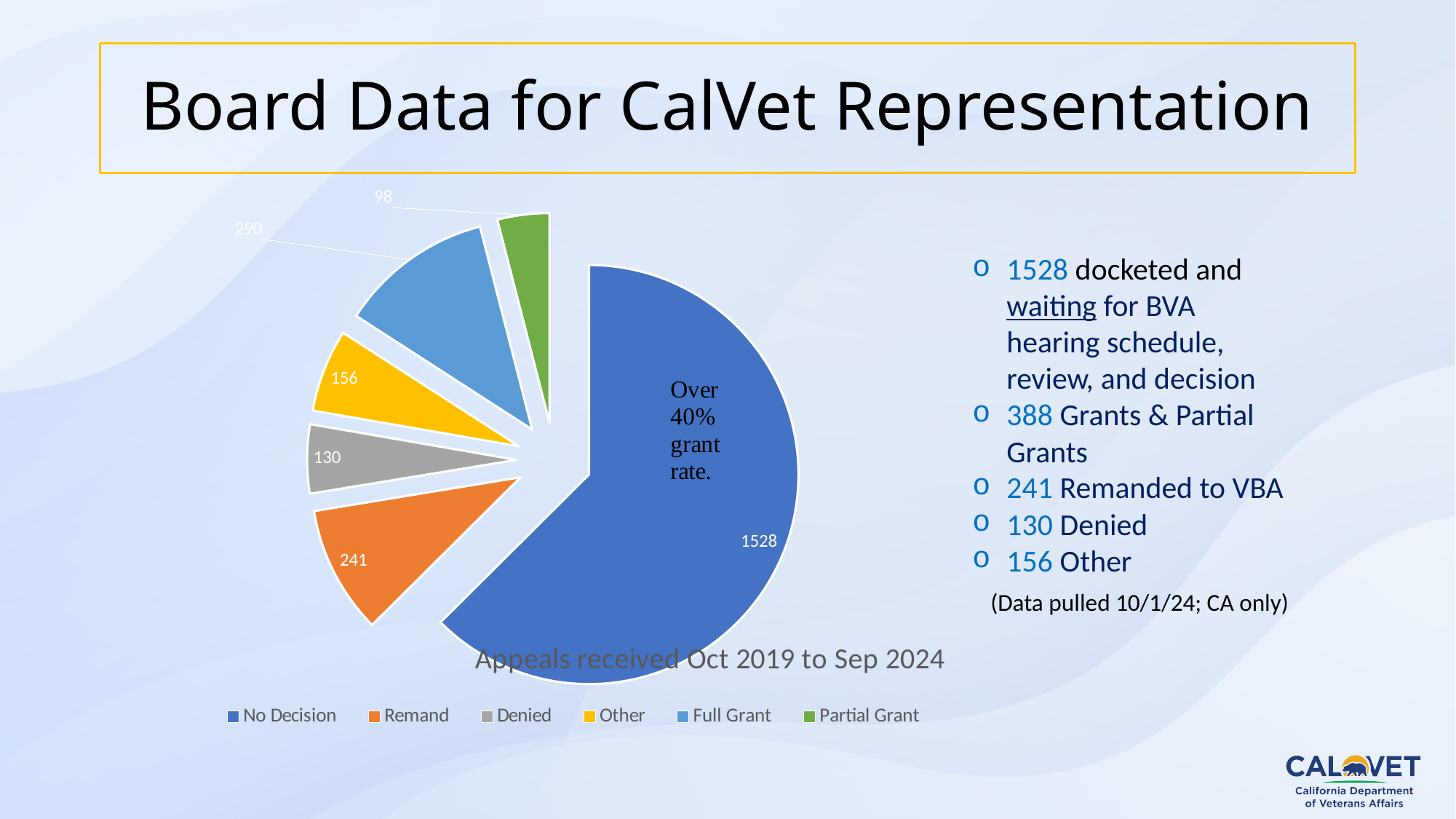
What is the value for No Decision in the pie chart? 1528 Which category has the smallest slice in the pie chart? Partial Grant Which is larger, the value for Other or the value for Denied? Other What is the value for Partial Grant in the pie chart? 98 How many categories does the pie chart show? 6 What is the value for Full Grant in the pie chart? 290 What is the value for Remand in the pie chart? 241 What is the title of the pie chart? Appeals received Oct 2019 to Sep 2024 What is the difference between the Full Grant and Partial Grant values? 192 What type of chart is shown on the slide? pie chart What colour is the Remand slice in the pie chart? orange Which category has the largest slice in the pie chart? No Decision